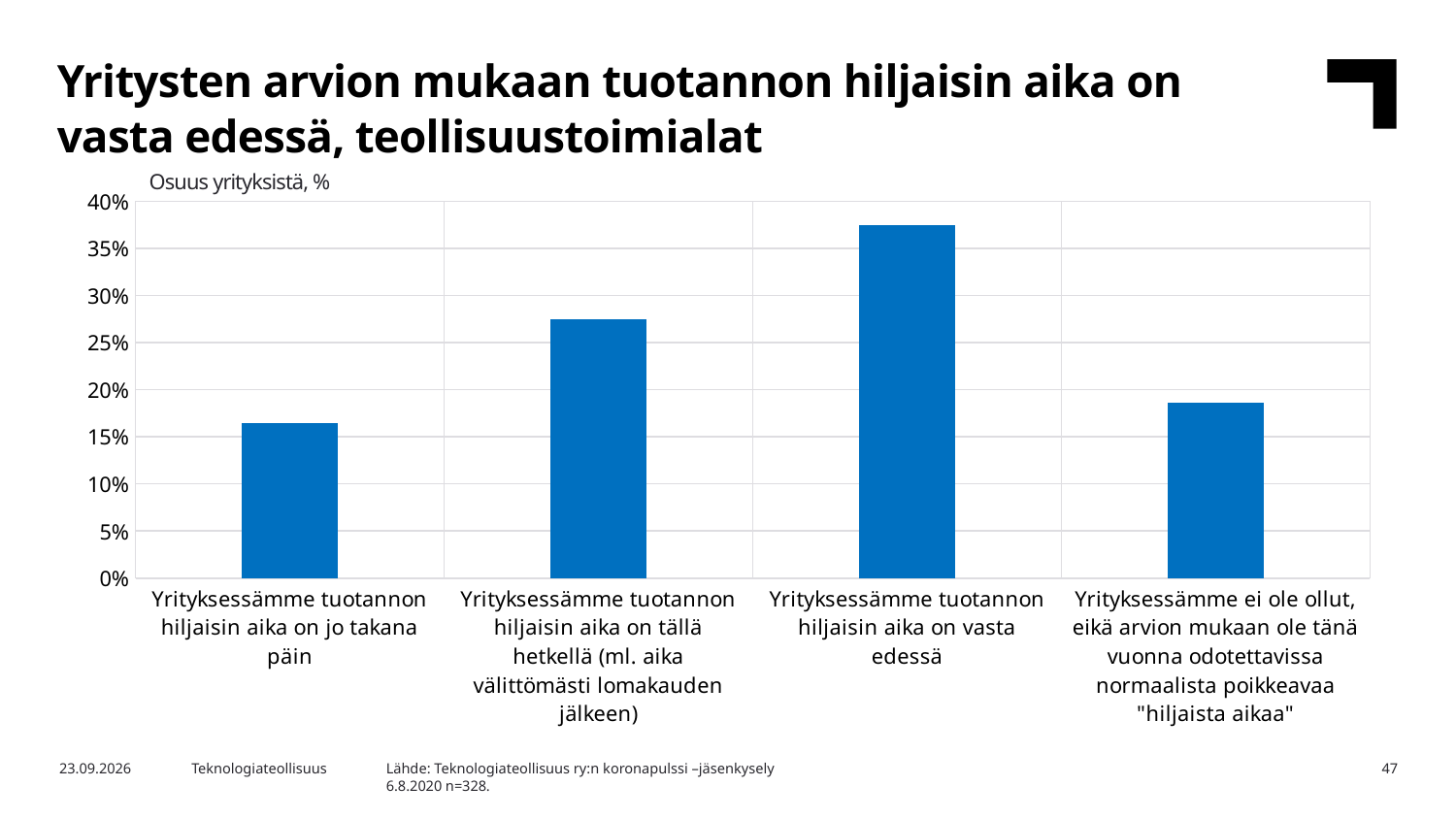
Is the value for "Yrityksessämme tuotannon hiljaisin aika on vasta edessä" greater or less than 35%? greater Which category has the lowest value in the chart? Yrityksessämme tuotannon hiljaisin aika on jo takana päin Which is larger: the value for "Yrityksessämme tuotannon hiljaisin aika on tällä hetkellä" or the value for "Yrityksessämme tuotannon hiljaisin aika on vasta edessä"? Yrityksessämme tuotannon hiljaisin aika on vasta edessä Is the value for "Yrityksessämme tuotannon hiljaisin aika on jo takana päin" greater or less than 20%? less Which category has the highest value in the chart? Yrityksessämme tuotannon hiljaisin aika on vasta edessä How many categories are shown on the x axis of the chart? 4 What is the label shown above the vertical axis of the chart? Osuus yrityksistä, % Is the value for "Yrityksessämme tuotannon hiljaisin aika on tällä hetkellä (ml. aika välittömästi lomakauden jälkeen)" greater or less than 25%? greater Which is larger: the value for "Yrityksessämme tuotannon hiljaisin aika on jo takana päin" or the value for "Yrityksessämme ei ole ollut, eikä arvion mukaan ole tänä vuonna odotettavissa normaalista poikkeavaa 'hiljaista aikaa'"? Yrityksessämme ei ole ollut, eikä arvion mukaan ole tänä vuonna odotettavissa normaalista poikkeavaa "hiljaista aikaa" What kind of chart is shown on the slide? bar chart What is the maximum value shown on the vertical axis of the chart? 40%